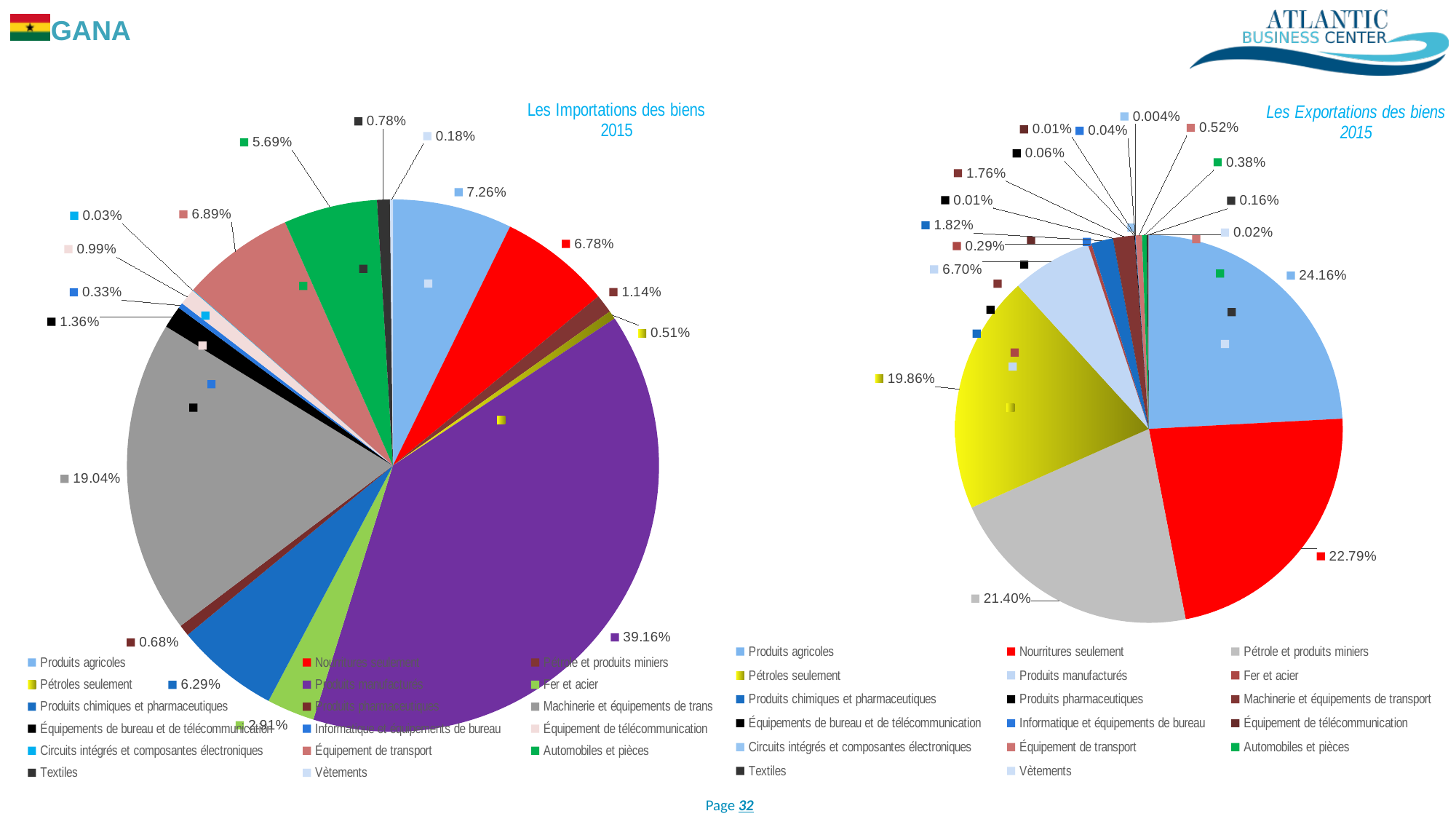
In 'Les Importations des biens 2015', what is the share for Produits agricoles? 7.26% In 'Les Importations des biens 2015', what is the largest slice's value? 39.16% In 'Les Exportations des biens 2015', what is the share for Nourritures seulement? 22.79% In 'Les Exportations des biens 2015', what is the difference between Produits agricoles (24.16%) and Nourritures seulement (22.79%)? 1.37% How many pie charts are shown on the slide? 2 In 'Les Importations des biens 2015', what is the share for Machinerie et équipements de transport? 19.04% In 'Les Importations des biens 2015', what is the difference between the Produits manufacturés share (39.16%) and the Machinerie et équipements de transport share (19.04%)? 20.12% In 'Les Exportations des biens 2015', which category has the largest share? Produits agricoles What type of chart is 'Les Importations des biens 2015'? pie chart In 'Les Exportations des biens 2015', what is the share for Pétroles seulement? 19.86% In 'Les Importations des biens 2015', which category has the largest share? Produits manufacturés In 'Les Exportations des biens 2015', which is larger: Pétrole et produits miniers or Produits manufacturés? Pétrole et produits miniers